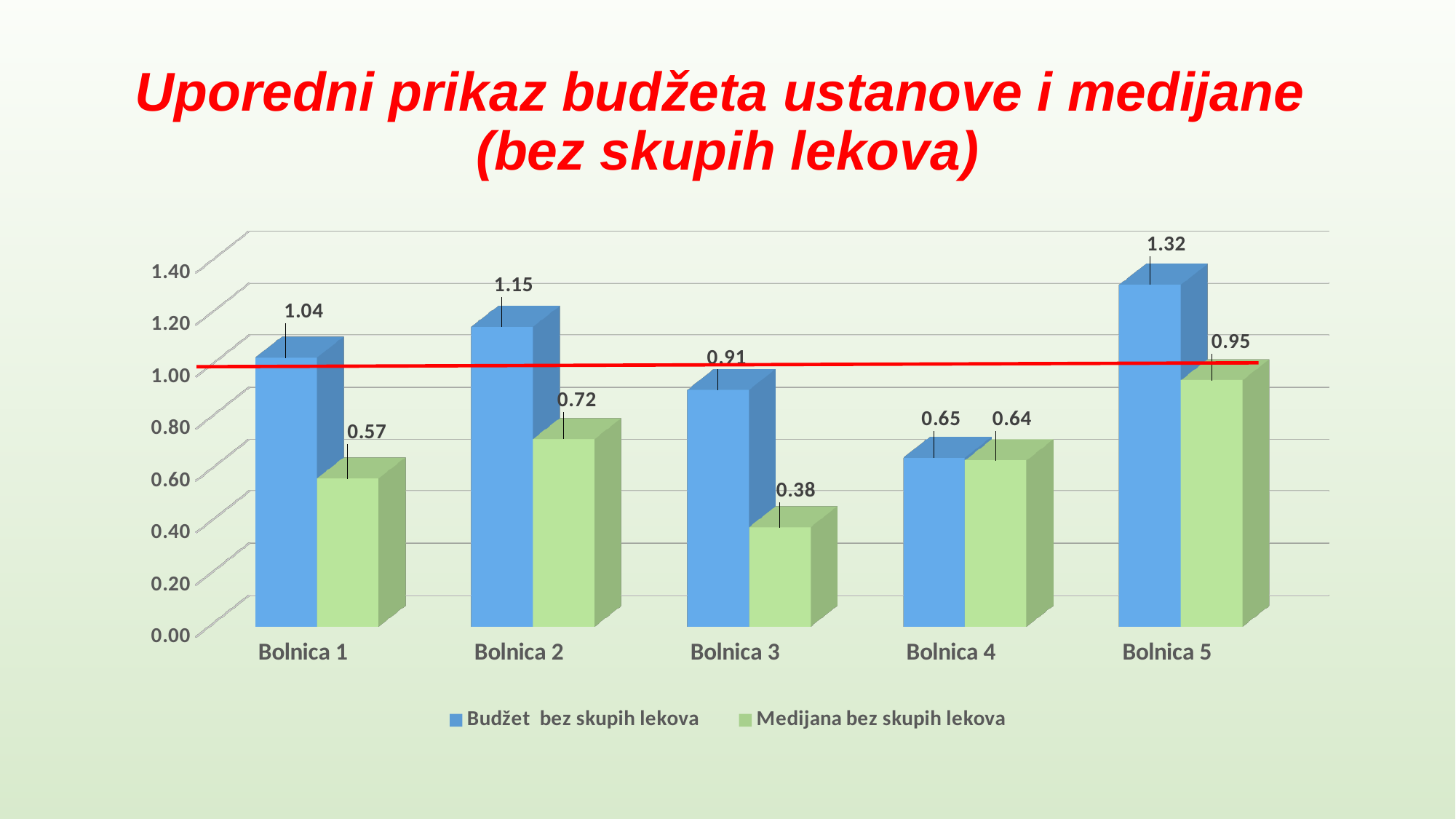
How many hospitals are shown on the x axis? 5 Which hospital has the lowest "Medijana bez skupih lekova" value? Bolnica 3 What is the difference between the "Budžet bez skupih lekova" and "Medijana bez skupih lekova" values for Bolnica 1? 0.47 What kind of chart is shown on the slide? Bar chart Which is larger for Bolnica 5: "Budžet bez skupih lekova" or "Medijana bez skupih lekova"? Budžet bez skupih lekova How many series does the legend list? 2 What is the value of "Budžet bez skupih lekova" for Bolnica 3? 0.91 Which hospital has the highest "Budžet bez skupih lekova" value? Bolnica 5 What is the value of "Medijana bez skupih lekova" for Bolnica 2? 0.72 Is the "Budžet bez skupih lekova" value for Bolnica 2 greater or less than 1.00? greater What is the "Medijana bez skupih lekova" value for Bolnica 4? 0.64 Which colour represents "Medijana bez skupih lekova" in the chart? Green